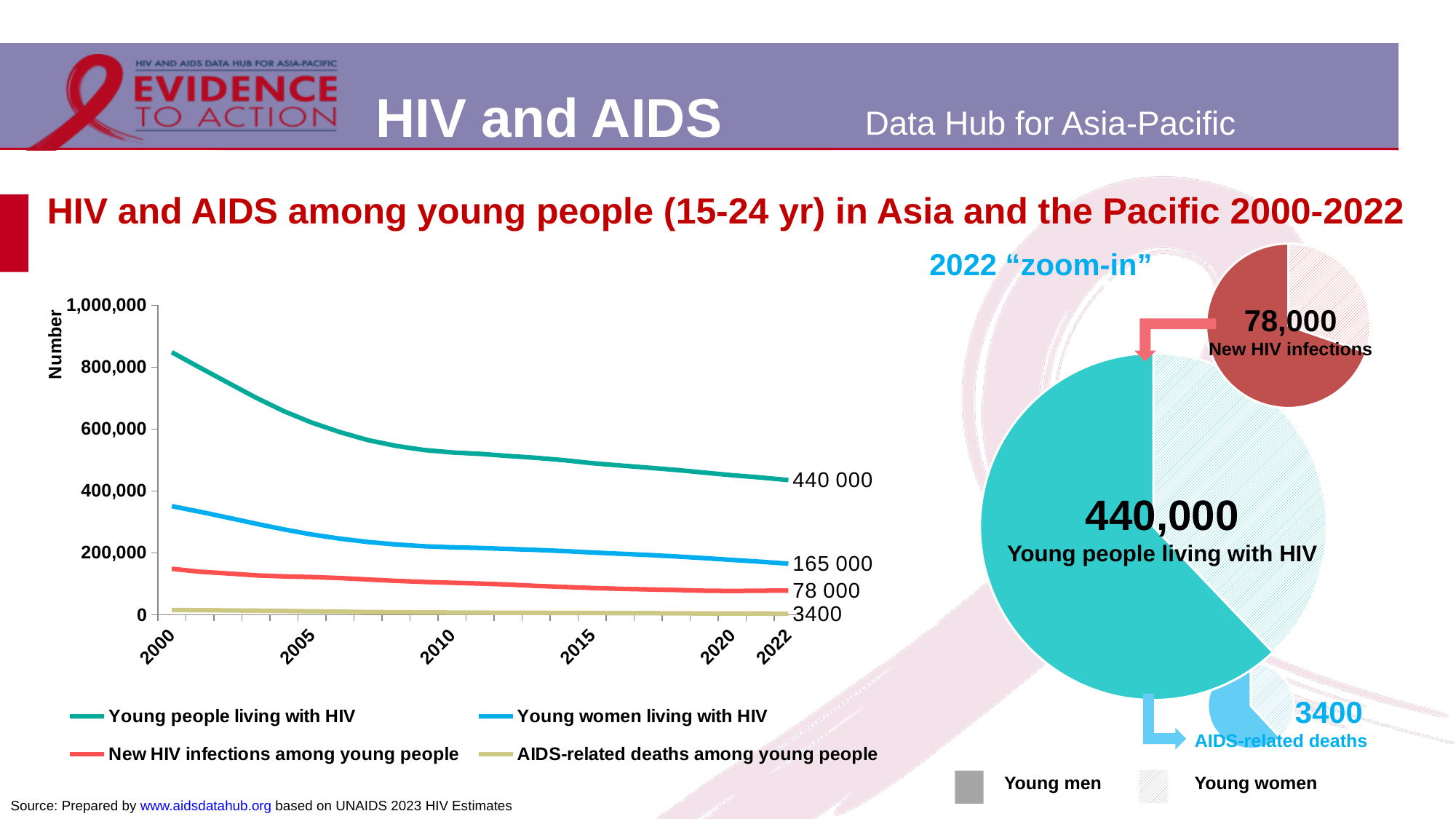
In the line chart, is the value for Young people living with HIV in 2000 greater or less than 800,000? greater In the line chart, what is the value for New HIV infections among young people in 2022? 78 000 In the line chart, what is the value for Young people living with HIV in 2022? 440 000 In the line chart, is the value for Young women living with HIV in 2000 greater or less than 400,000? less How many series does the legend of the line chart list? 4 In the line chart, what is the value for Young women living with HIV in 2022? 165 000 In the line chart, what is the value for AIDS-related deaths among young people in 2022? 3400 What kind of chart is the chart on the left of the slide? line chart In the 2022 "zoom-in" graphic on the right, what number of AIDS-related deaths is shown? 3400 In the line chart, does the Young people living with HIV series rise or fall from 2000 to 2022? fall In the line chart, which series has the highest value in 2022? Young people living with HIV In the line chart, what is the difference between Young people living with HIV and Young women living with HIV in 2022? 275 000